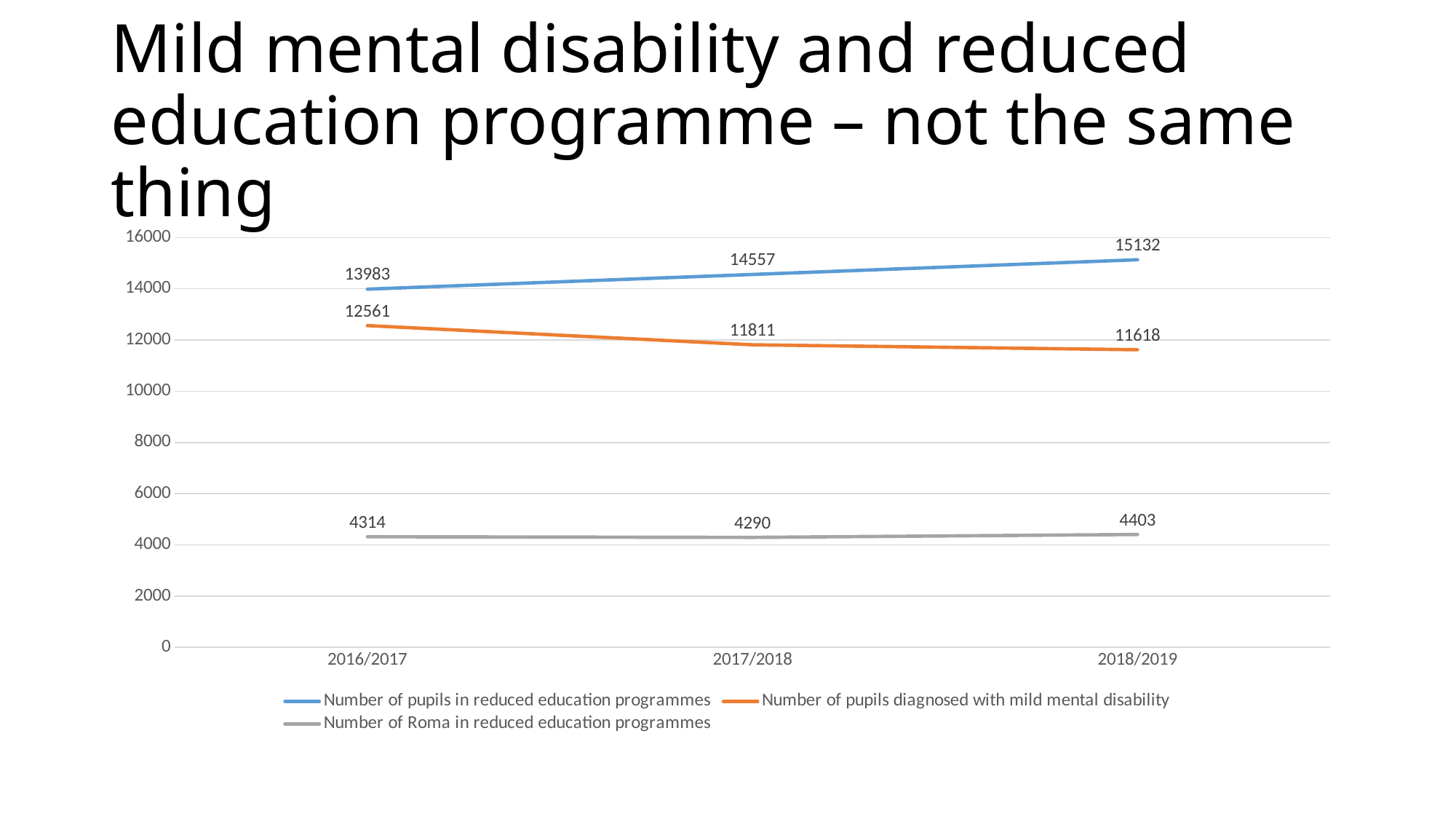
What is the number of pupils diagnosed with mild mental disability in 2017/2018? 11811 Which is larger in 2016/2017: the number of pupils in reduced education programmes or the number of pupils diagnosed with mild mental disability? Number of pupils in reduced education programmes In which school year is the number of pupils in reduced education programmes highest? 2018/2019 How many series does the legend list? 3 Which colour is the line for the number of Roma in reduced education programmes? grey Does the number of pupils diagnosed with mild mental disability rise or fall from 2016/2017 to 2018/2019? fall How many school years are shown on the x axis? 3 What is the difference between the number of pupils in reduced education programmes and the number of pupils diagnosed with mild mental disability in 2018/2019? 3514 What is the number of pupils in reduced education programmes in 2016/2017? 13983 What type of chart is shown on the slide? line chart What is the number of Roma in reduced education programmes in 2018/2019? 4403 In which school year is the number of pupils diagnosed with mild mental disability lowest? 2018/2019